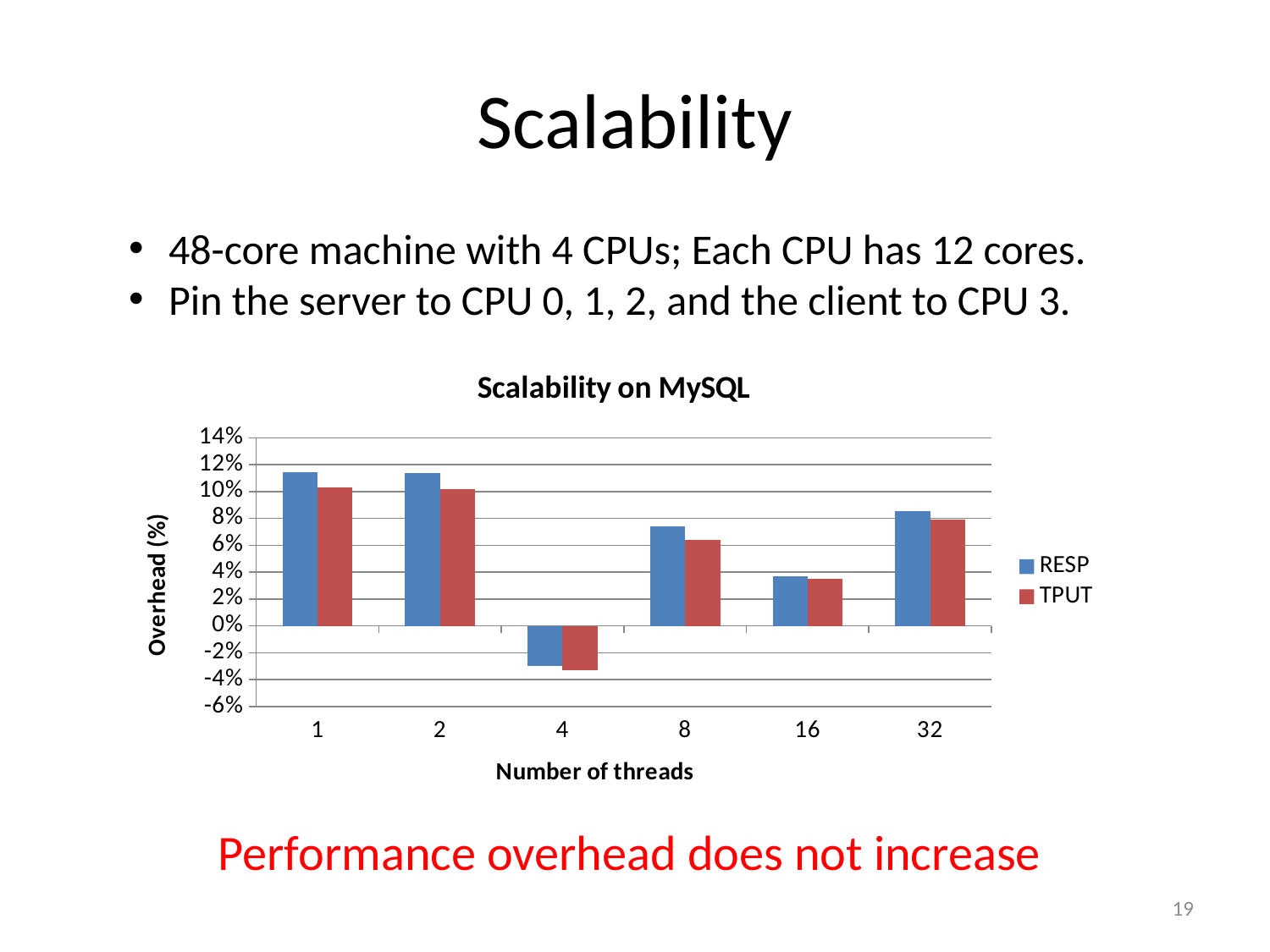
Which number of threads has the lowest TPUT overhead? 4 Which is larger at 1 thread, the RESP overhead or the TPUT overhead? RESP Is the RESP overhead for 16 threads greater or less than 2%? greater Is the TPUT overhead for 8 threads greater or less than 8%? less What is the title of the chart? Scalability on MySQL Is the RESP overhead for 4 threads greater or less than 0%? less How many series does the legend list? 2 How many thread counts are shown on the x axis? 6 Which number of threads has the lowest RESP overhead? 4 Which is larger, the RESP overhead for 8 threads or for 16 threads? 8 threads What type of chart is shown on the slide? bar chart